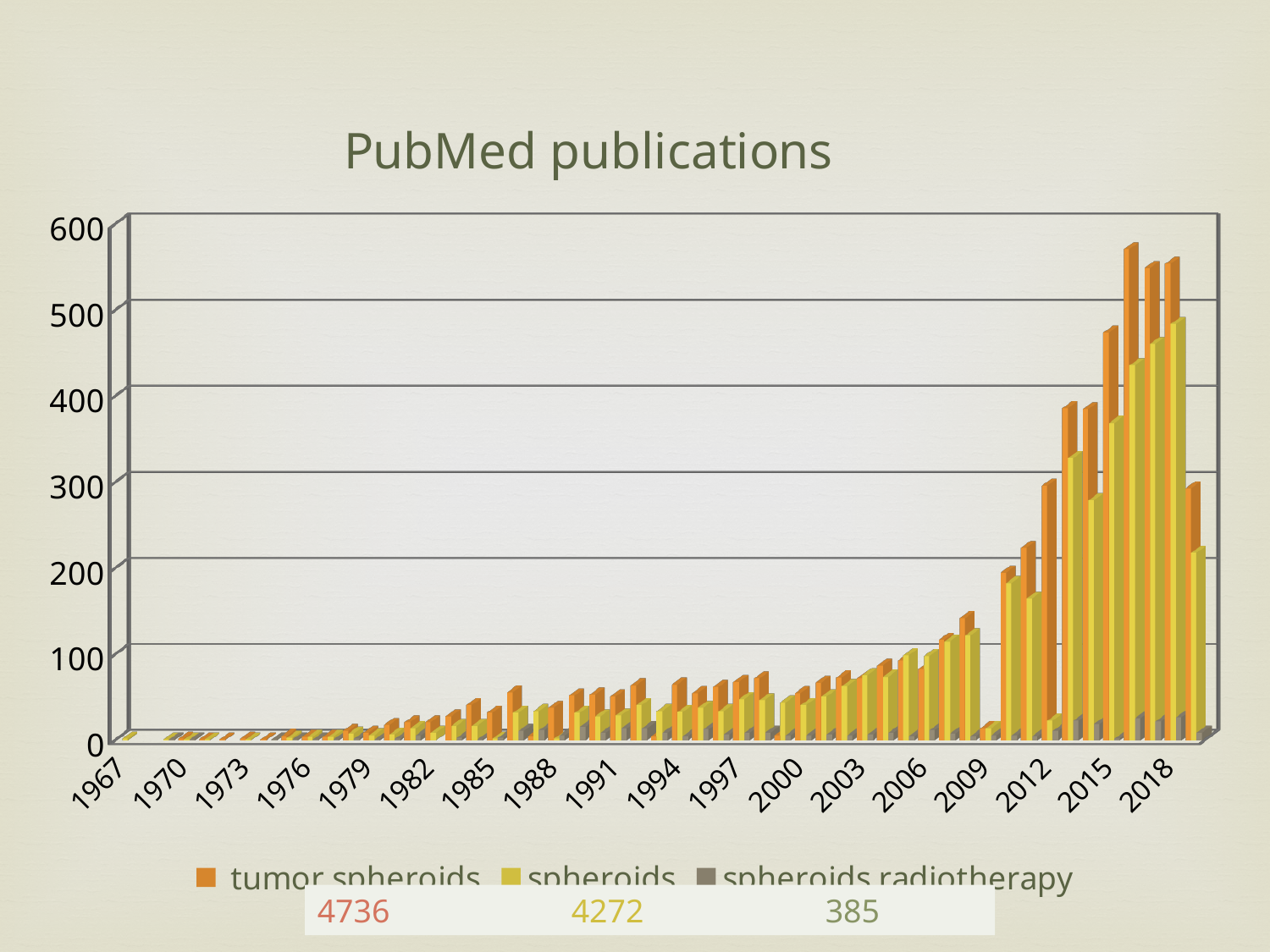
Do the tumor spheroids values generally rise or fall from 1967 to 2018? rise What number is printed below the legend under tumor spheroids? 4736 What is the title of the chart? PubMed publications Which series has the lowest bars across the chart? spheroids radiotherapy Is the value for tumor spheroids in 1970 greater or less than 100? less Is the value for tumor spheroids in 2012 greater or less than 100? greater What kind of chart is shown on the slide? bar chart How many series does the legend list? 3 Which series has the tallest bar on the chart? tumor spheroids In 2012, which is larger: tumor spheroids or spheroids? tumor spheroids How many year labels are shown on the x axis? 18 Is the value for spheroids radiotherapy in 2009 greater or less than 100? less